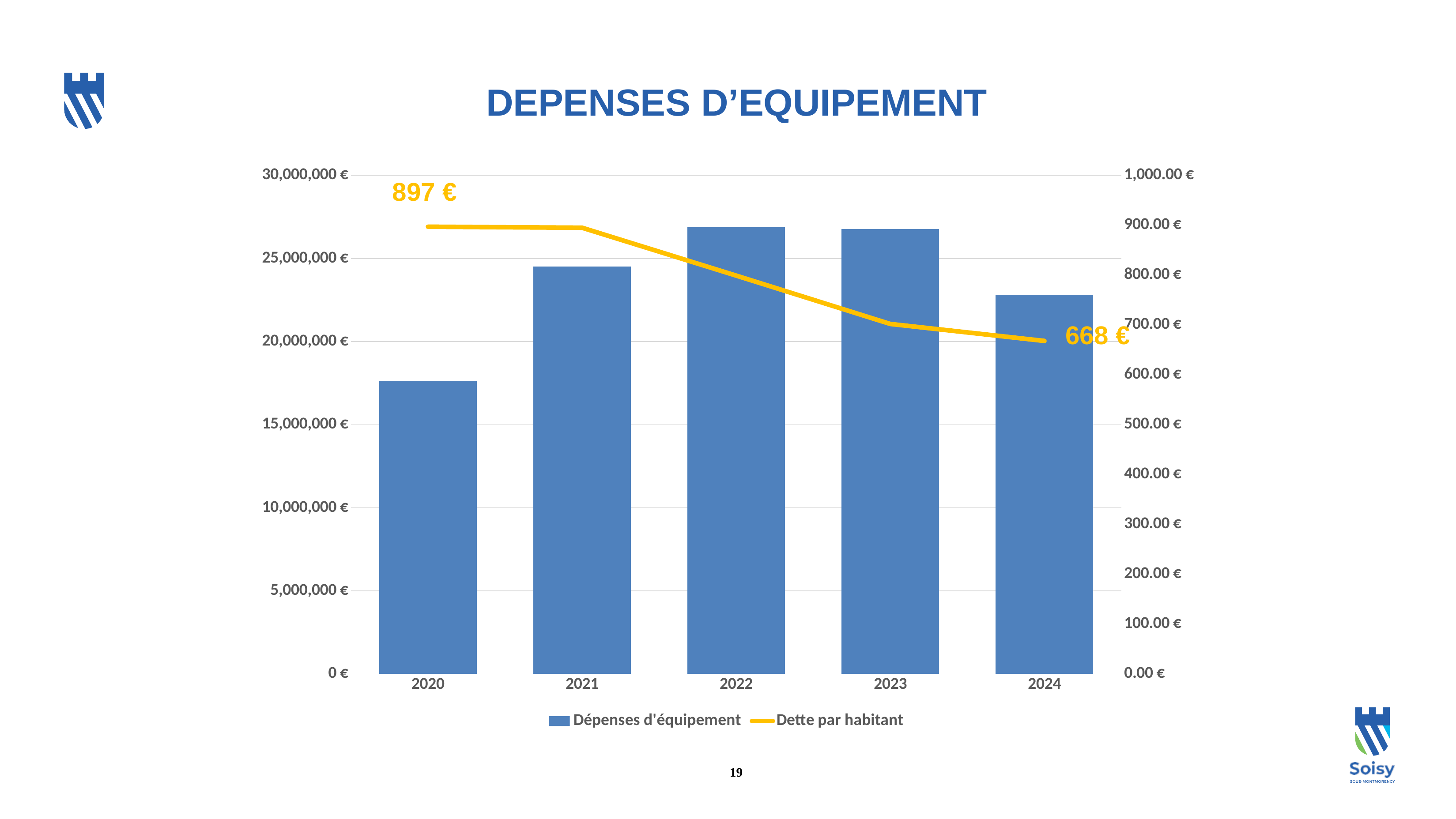
Is the value of Dépenses d'équipement for 2024 greater or less than 20,000,000 €? greater Is the value of Dépenses d'équipement for 2022 greater or less than 25,000,000 €? greater By how much did Dette par habitant fall between 2020 and 2024? 229 € How many years are shown on the x axis? 5 Which year has the lowest Dépenses d'équipement? 2020 How many series does the legend list? 2 Is the value of Dépenses d'équipement for 2020 greater or less than 20,000,000 €? less Which is larger, Dépenses d'équipement in 2021 or in 2024? 2021 What is the value of Dette par habitant in 2020? 897 € What is the title of the chart? DEPENSES D'EQUIPEMENT What is the value of Dette par habitant in 2024? 668 € Does Dette par habitant rise or fall from 2020 to 2024? fall